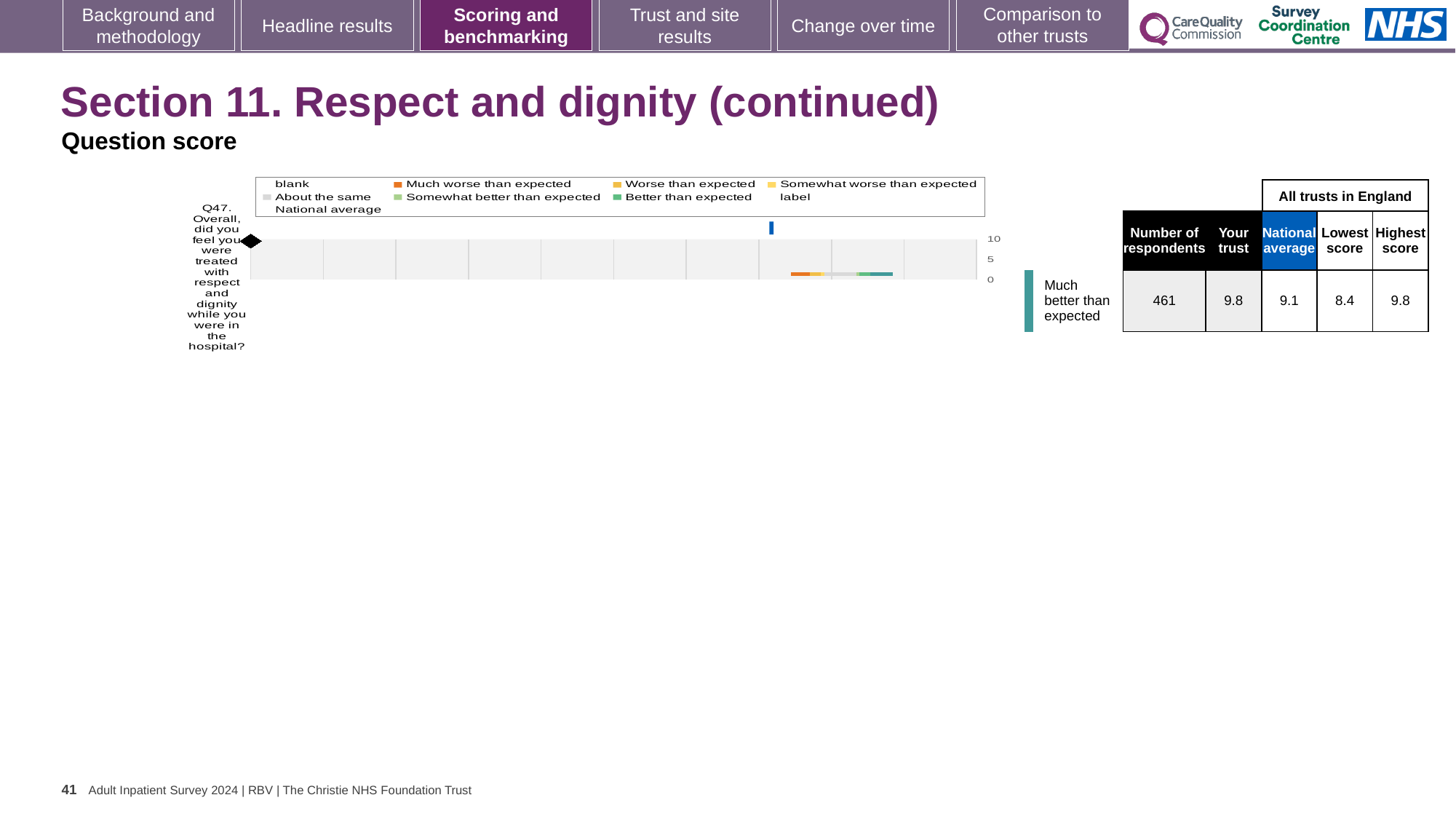
How many survey questions are plotted on the chart? 1 Which question number is plotted on the chart? Q47 What is the 'Your trust' score for Q47? 9.8 How many respondents answered Q47? 461 What kind of chart is shown on the slide? bar chart Is the 'Your trust' score for Q47 greater or less than 5 on the chart axis? greater Which is larger for Q47, the 'Your trust' score or the national average? Your trust Which benchmark category is the trust's Q47 result assigned to? Much better than expected What is the lowest score among all trusts in England for Q47? 8.4 What is the national average score for Q47? 9.1 What is the difference between the 'Your trust' score and the national average for Q47? 0.7 What is the highest score among all trusts in England for Q47? 9.8